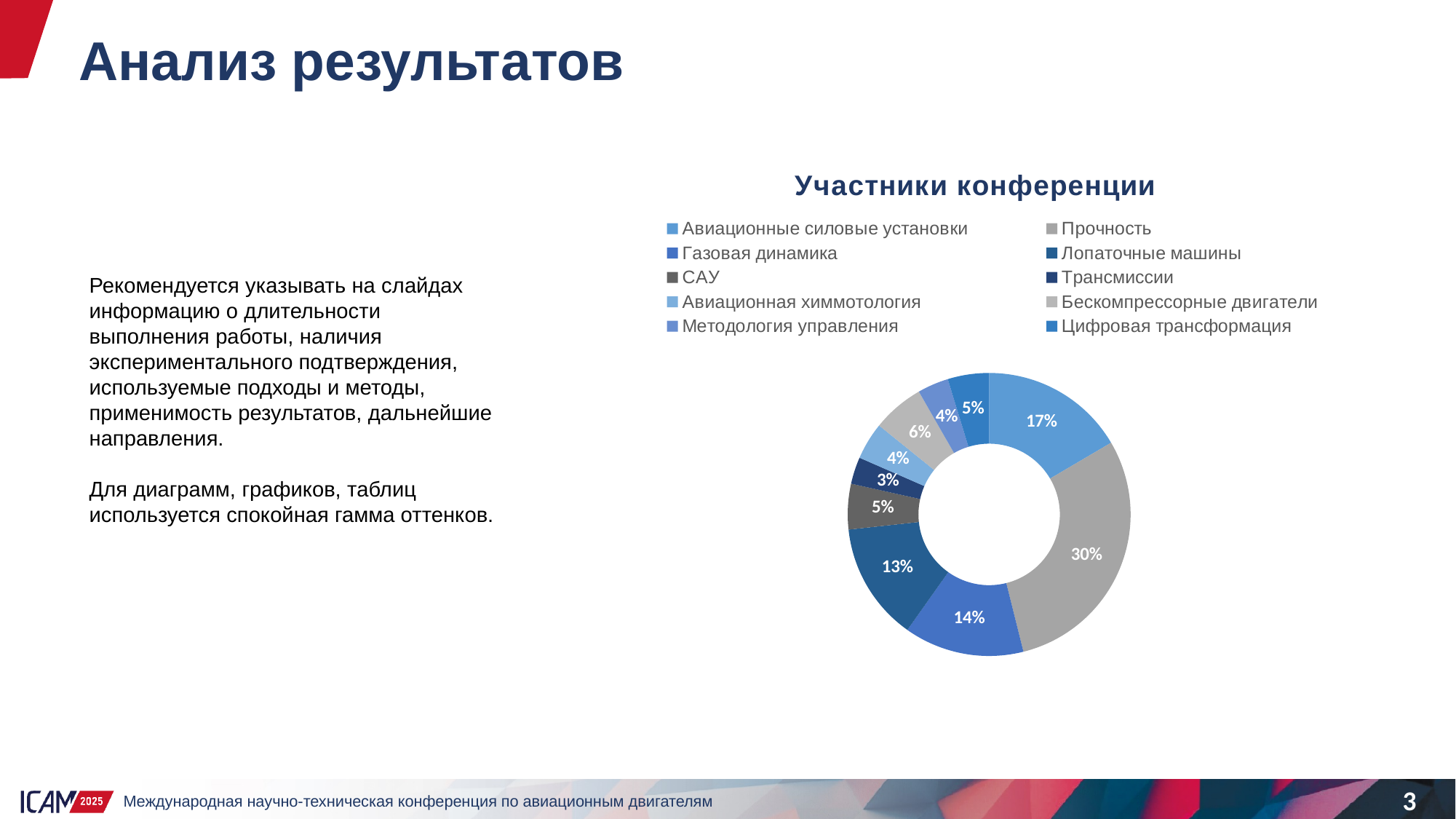
How many categories are shown in the chart? 10 Which is larger, the share of Газовая динамика or the share of Лопаточные машины? Газовая динамика What type of chart is shown on the slide? Doughnut (pie) chart Which category has the smallest share of the chart? Трансмиссии What is the value for Газовая динамика? 14% What is the value for Лопаточные машины? 13% What share of the pie does Прочность have? 30% What is the title of the chart? Участники конференции What is the difference between the shares of Прочность and Авиационные силовые установки? 13% Which category has the largest share of the chart? Прочность What is the value for Авиационные силовые установки? 17% What is the value for Бескомпрессорные двигатели? 6%